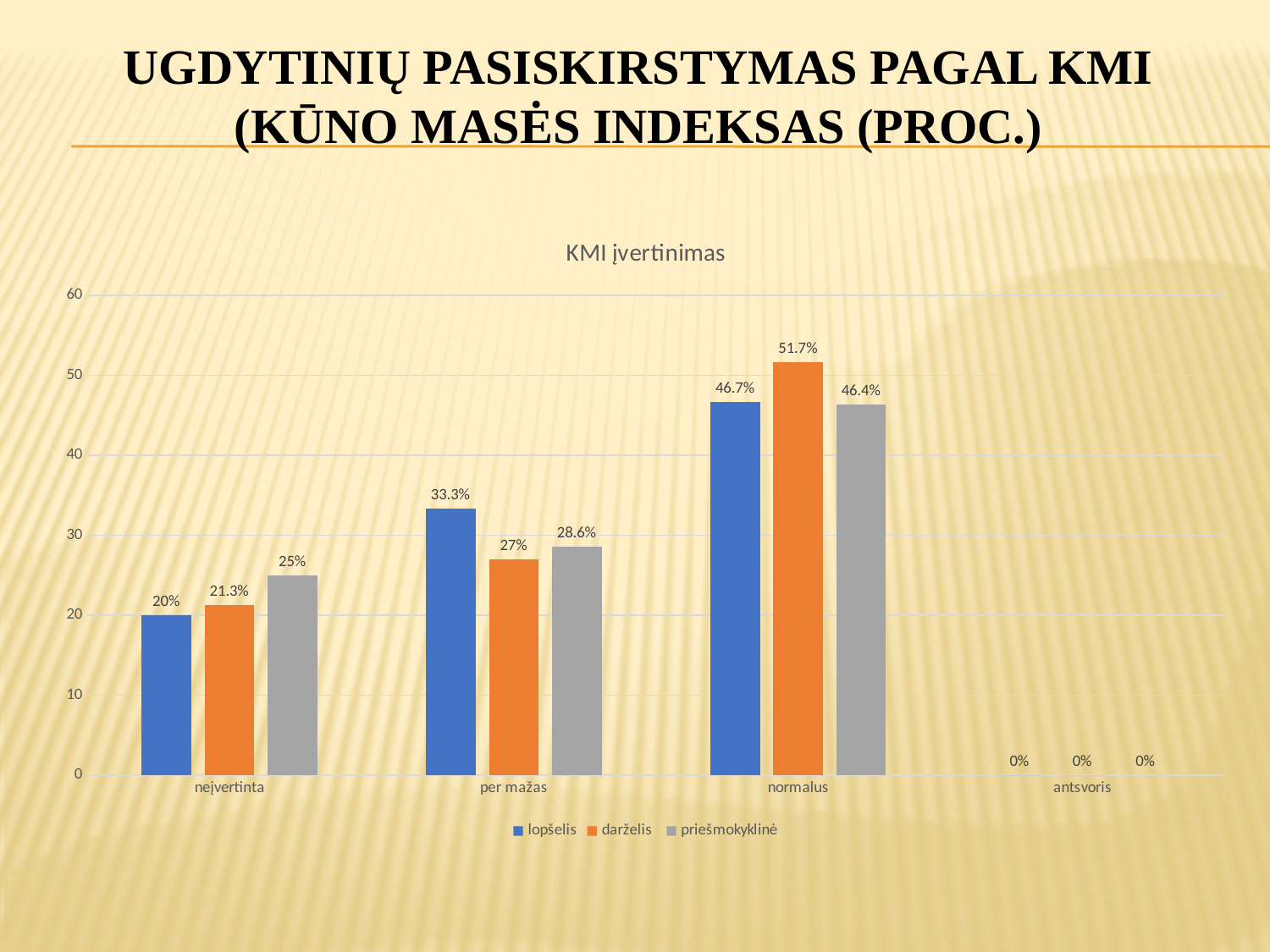
Which is larger in the per mažas category: lopšelis or priešmokyklinė? lopšelis What is the value for darželis in the per mažas category? 27% How many categories are shown on the x axis? 4 Is the value for darželis in the normalus category greater or less than 50? greater Which category has the lowest values for all three series? antsvoris What is the value for lopšelis in the normalus category? 46.7% What is the value for priešmokyklinė in the neįvertinta category? 25% What is the title of the chart? KMI įvertinimas Which series has the highest value in the normalus category? darželis How many series does the legend list? 3 What kind of chart is shown on the slide? bar chart What is the difference between the darželis and lopšelis values in the normalus category? 5%